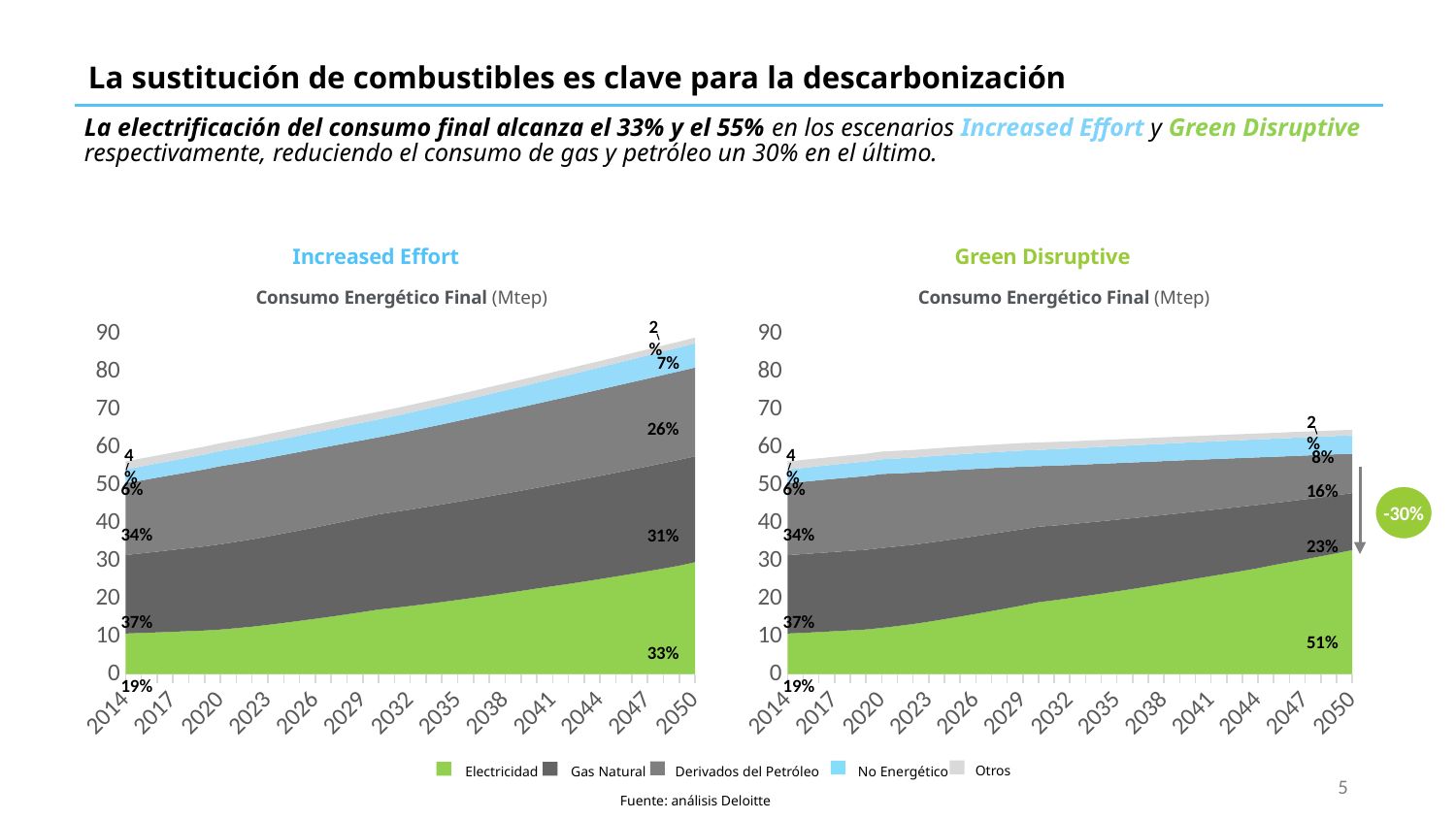
How many series does the legend list? 5 In the Green Disruptive chart, what is the share of No Energético in 2050? 8% What kind of chart is the Increased Effort chart? Stacked area chart In the Increased Effort chart, what is the share of Gas Natural in 2014? 37% In the Increased Effort chart, what share of final energy consumption does Electricidad have in 2050? 33% In the Green Disruptive chart, what share of final energy consumption does Electricidad have in 2050? 51% In the Green Disruptive chart, what is the share of Derivados del Petróleo in 2050? 16% What is the difference between the 2050 Electricidad share in the Green Disruptive chart and in the Increased Effort chart? 18% In the Green Disruptive chart, is the total final energy consumption in 2050 greater or less than 70 Mtep? less In the Green Disruptive chart, which series has the smallest share in 2050? Otros In the Increased Effort chart, which series has the largest share in 2050? Electricidad In the Increased Effort chart, is the total final energy consumption in 2050 greater or less than 80 Mtep? greater